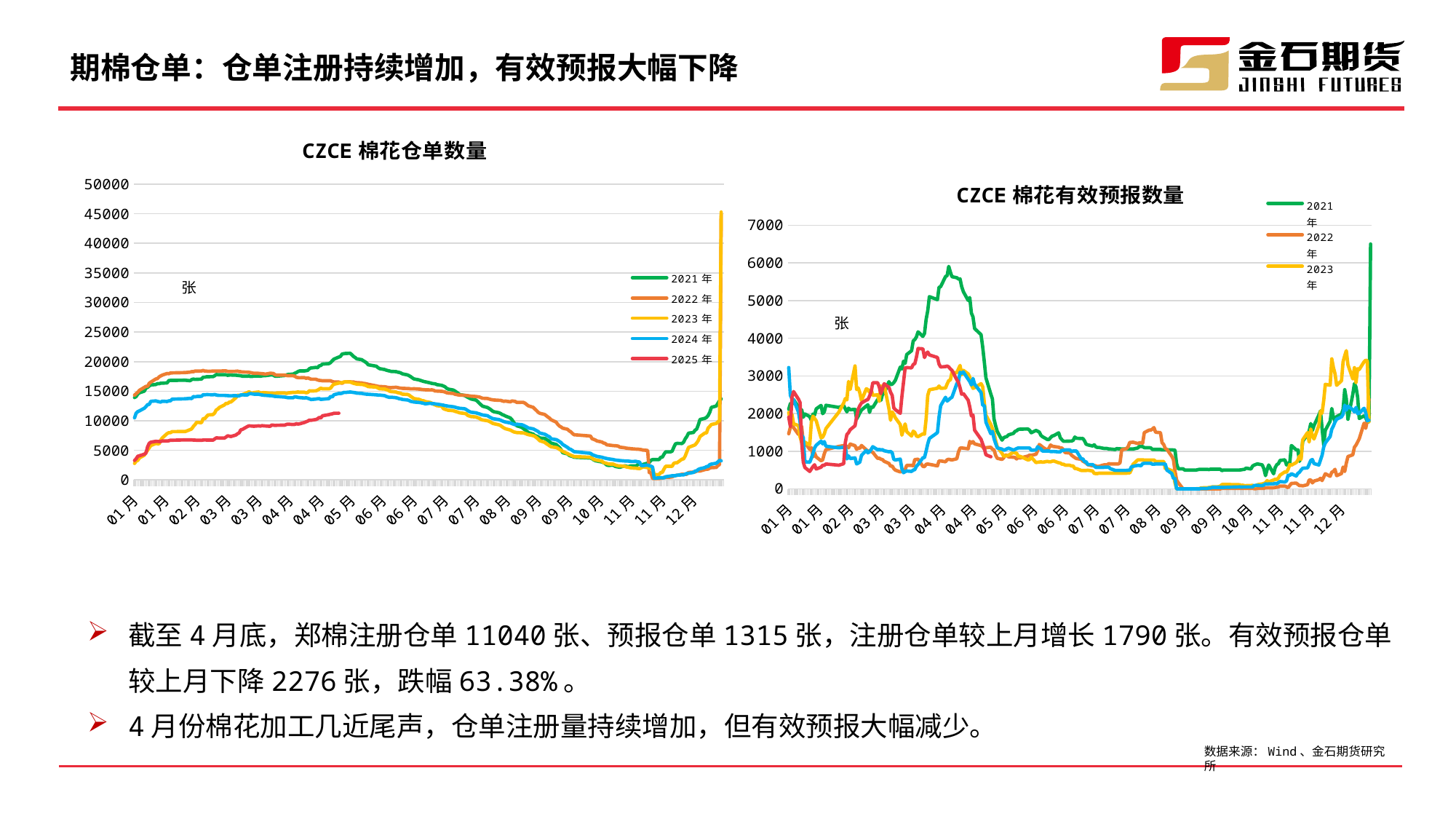
In the 'CZCE 棉花有效预报数量' chart, is the peak of the 2021年 series around 04月 greater or less than 5000? greater How many series does the legend of the 'CZCE 棉花有效预报数量' chart list? 3 In the 'CZCE 棉花仓单数量' chart, which series reaches the highest value on the chart? 2023年 What kind of chart is the 'CZCE 棉花仓单数量' chart on the left? line chart In the 'CZCE 棉花有效预报数量' chart, is the value of the 2022年 series around 09月 greater or less than 1000? less In the 'CZCE 棉花仓单数量' chart, is the peak value of the 2021年 series greater or less than 20000? greater How many series does the legend of the 'CZCE 棉花仓单数量' chart list? 5 In the 'CZCE 棉花仓单数量' chart, does the 2022年 series rise or fall from 03月 to 11月? fall In the 'CZCE 棉花仓单数量' chart, which series is larger at 04月: 2021年 or 2025年? 2021年 In the 'CZCE 棉花有效预报数量' chart, which series reaches the highest value on the chart? 2021年 What unit label is shown on the y axis of the 'CZCE 棉花仓单数量' chart? 张